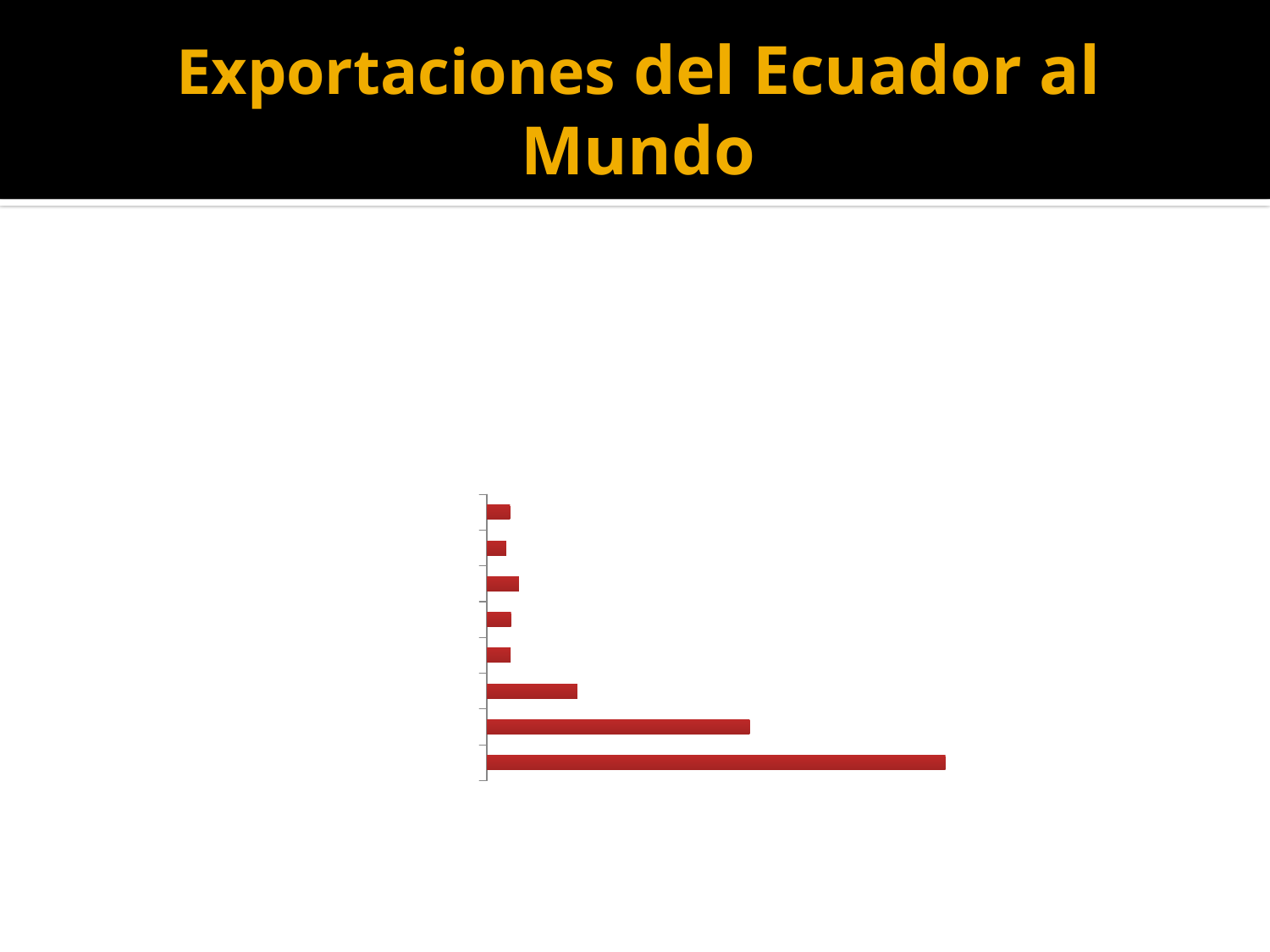
Do the bar lengths generally increase or decrease going from the top of the chart to the bottom? increase What colour are the bars in the chart? red What is the title of the slide containing the chart? Exportaciones del Ecuador al Mundo Which bar in the chart is the longest: the top bar or the bottom bar? the bottom bar How many bars does the chart on the slide contain? 8 What kind of chart is shown on the slide? bar chart Which bar is longer, the third bar from the bottom or the top bar? the third bar from the bottom Which bar is longer, the bottom bar or the bar directly above it? the bottom bar